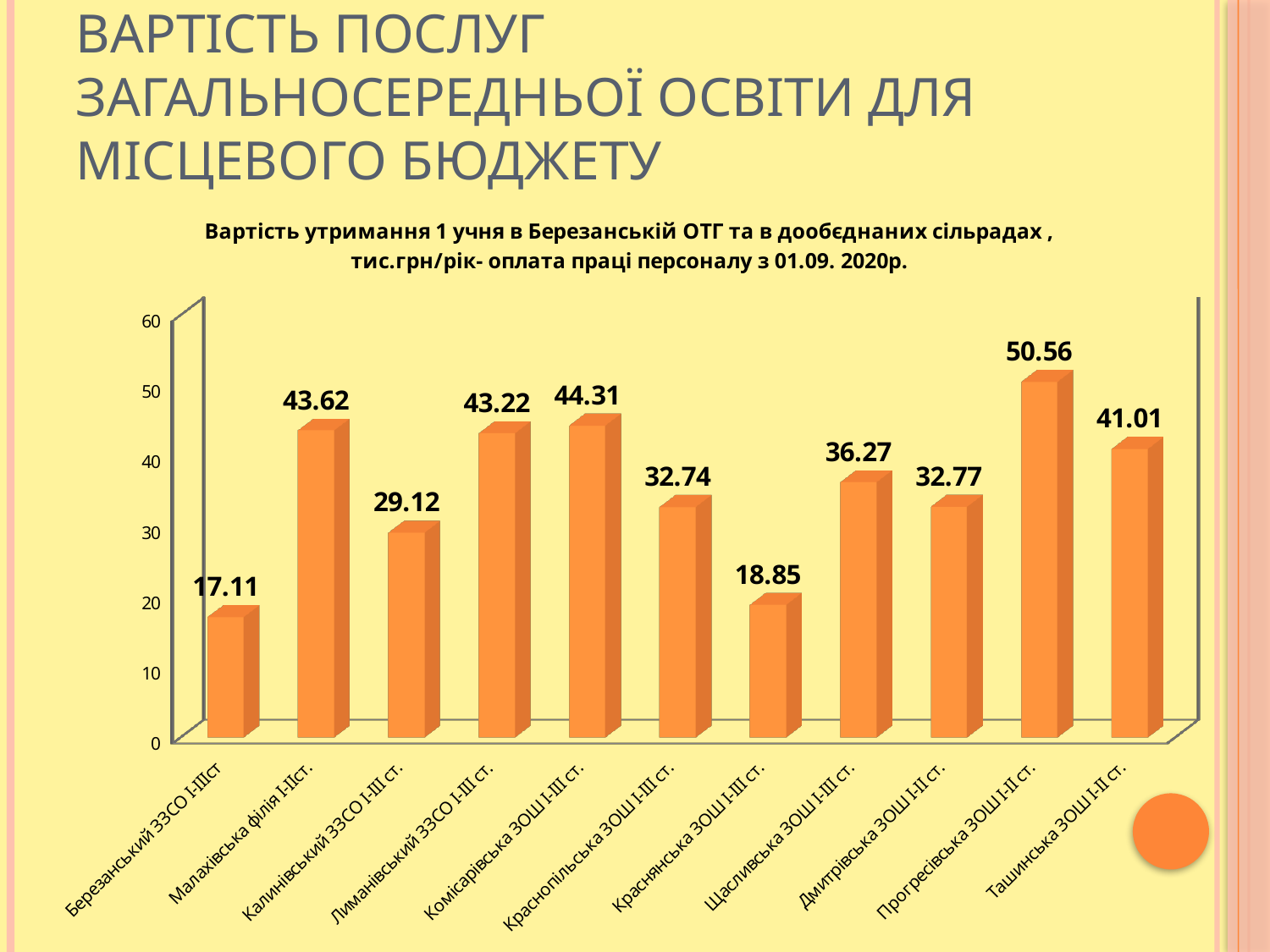
What is the difference between the values for Прогресівська ЗОШ І-ІІ ст. and Березанський ЗЗСО І-ІІІст? 33.45 What is the value for Прогресівська ЗОШ І-ІІ ст.? 50.56 What is the value for Березанський ЗЗСО І-ІІІст? 17.11 What is the value for Краснянська ЗОШ І-ІІІ ст.? 18.85 What is the value for Комісарівська ЗОШ І-ІІІ ст.? 44.31 What is the difference between the values for Малахівська філія І-ІІст. and Калинівський ЗЗСО І-ІІІ ст.? 14.5 What kind of chart is shown on the slide? Bar chart Which category has the lowest value? Березанський ЗЗСО І-ІІІст Which category has the highest value? Прогресівська ЗОШ І-ІІ ст. How many categories are shown on the chart? 11 Which is larger, the value for Щасливська ЗОШ І-ІІІ ст. or the value for Ташинська ЗОШ І-ІІ ст.? Ташинська ЗОШ І-ІІ ст. What unit is stated in the chart title for the values? тис.грн/рік